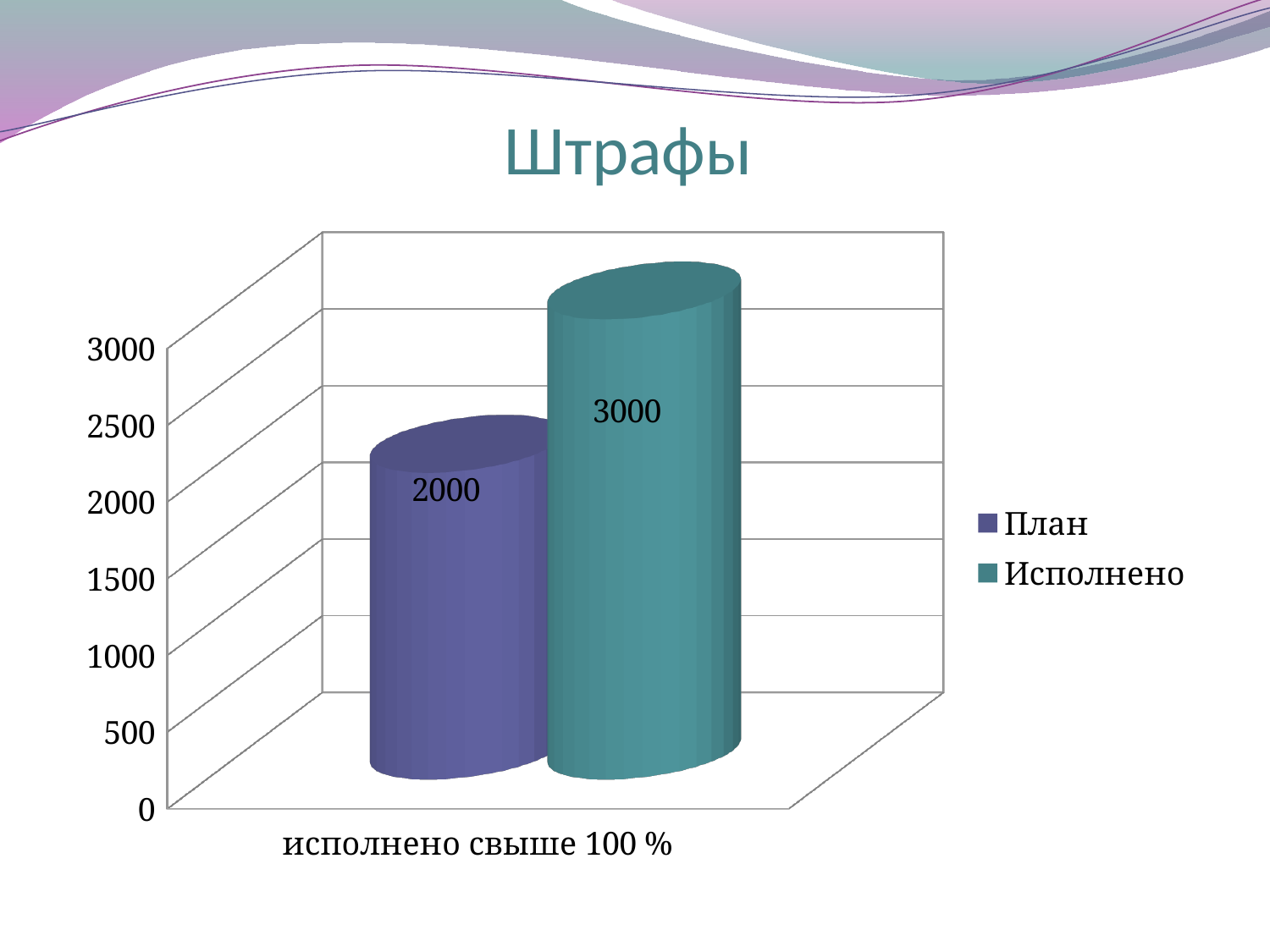
Which series has the higher value, План or Исполнено? Исполнено Which series has the lowest value? План Is the value for Исполнено greater or less than 2500? greater What is the title of the chart? Штрафы What kind of chart is shown on the slide? bar chart What is the value for План? 2000 What is the value for Исполнено? 3000 Which series has the highest value? Исполнено How many series does the legend list? 2 Is the value for План greater or less than 2500? less What is the difference between the Исполнено value and the План value? 1000 What is the category label shown on the x axis? исполнено свыше 100 %